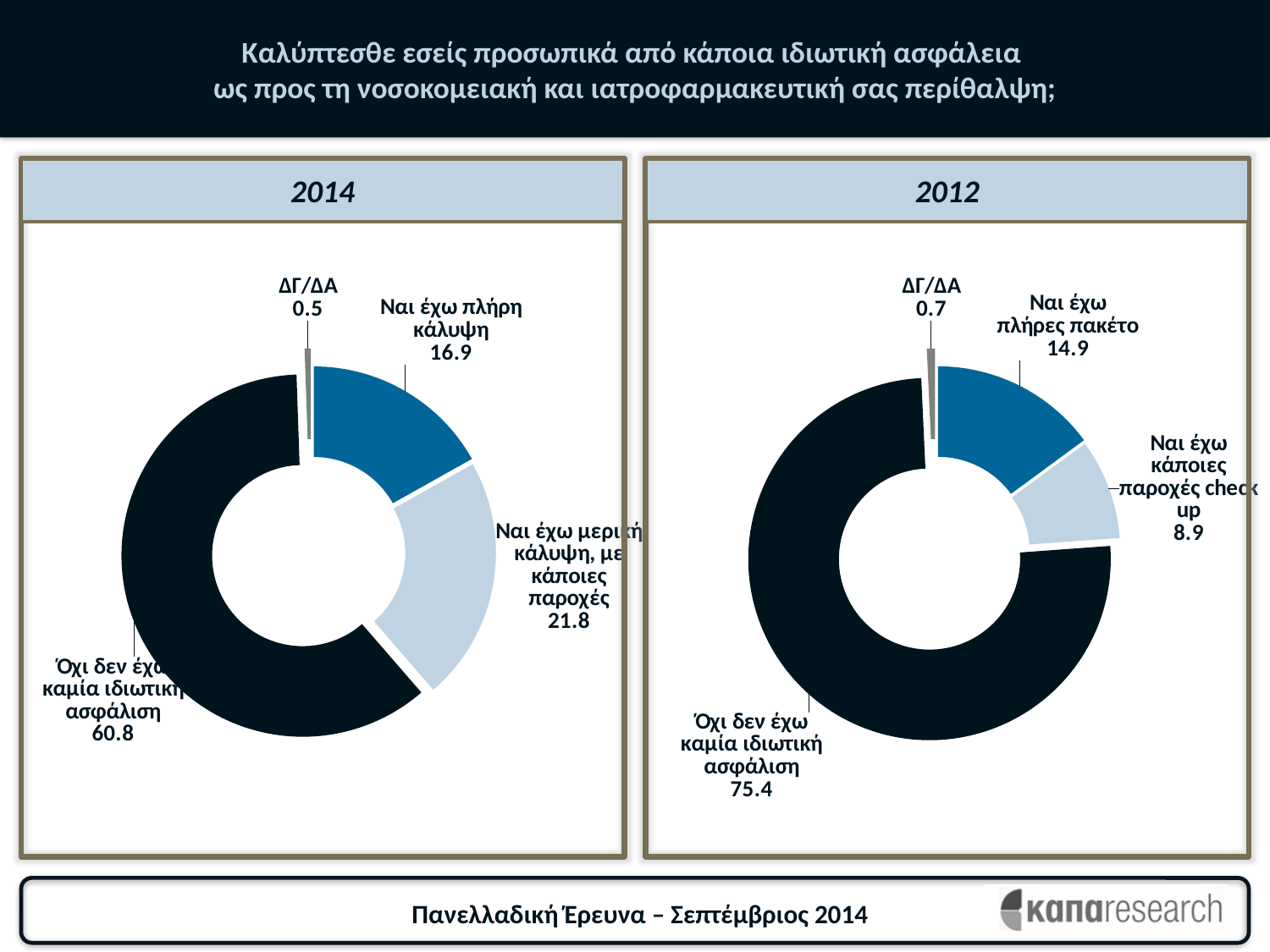
How many categories does the 2012 chart show? 4 In the 2014 chart, what is the difference between 'Ναι έχω μερική κάλυψη, με κάποιες παροχές' and 'Ναι έχω πλήρη κάλυψη'? 4.9 In the 2014 chart, which category has the smallest slice? ΔΓ/ΔΑ What type of chart is the 2014 chart? Donut (pie) chart In the 2012 chart, what is the value for 'ΔΓ/ΔΑ'? 0.7 In the 2014 chart, what is the value for 'Όχι δεν έχω καμία ιδιωτική ασφάλιση'? 60.8 In the 2012 chart, which category has the largest slice? Όχι δεν έχω καμία ιδιωτική ασφάλιση In the 2014 chart, what is the value for 'Ναι έχω πλήρη κάλυψη'? 16.9 What is the title of the chart on the right? 2012 What is the difference between the 'Όχι δεν έχω καμία ιδιωτική ασφάλιση' value in the 2012 chart and in the 2014 chart? 14.6 Which is larger: 'Ναι έχω πλήρη κάλυψη' in the 2014 chart or 'Ναι έχω πλήρες πακέτο' in the 2012 chart? Ναι έχω πλήρη κάλυψη in the 2014 chart In the 2012 chart, what is the value for 'Ναι έχω κάποιες παροχές check up'? 8.9